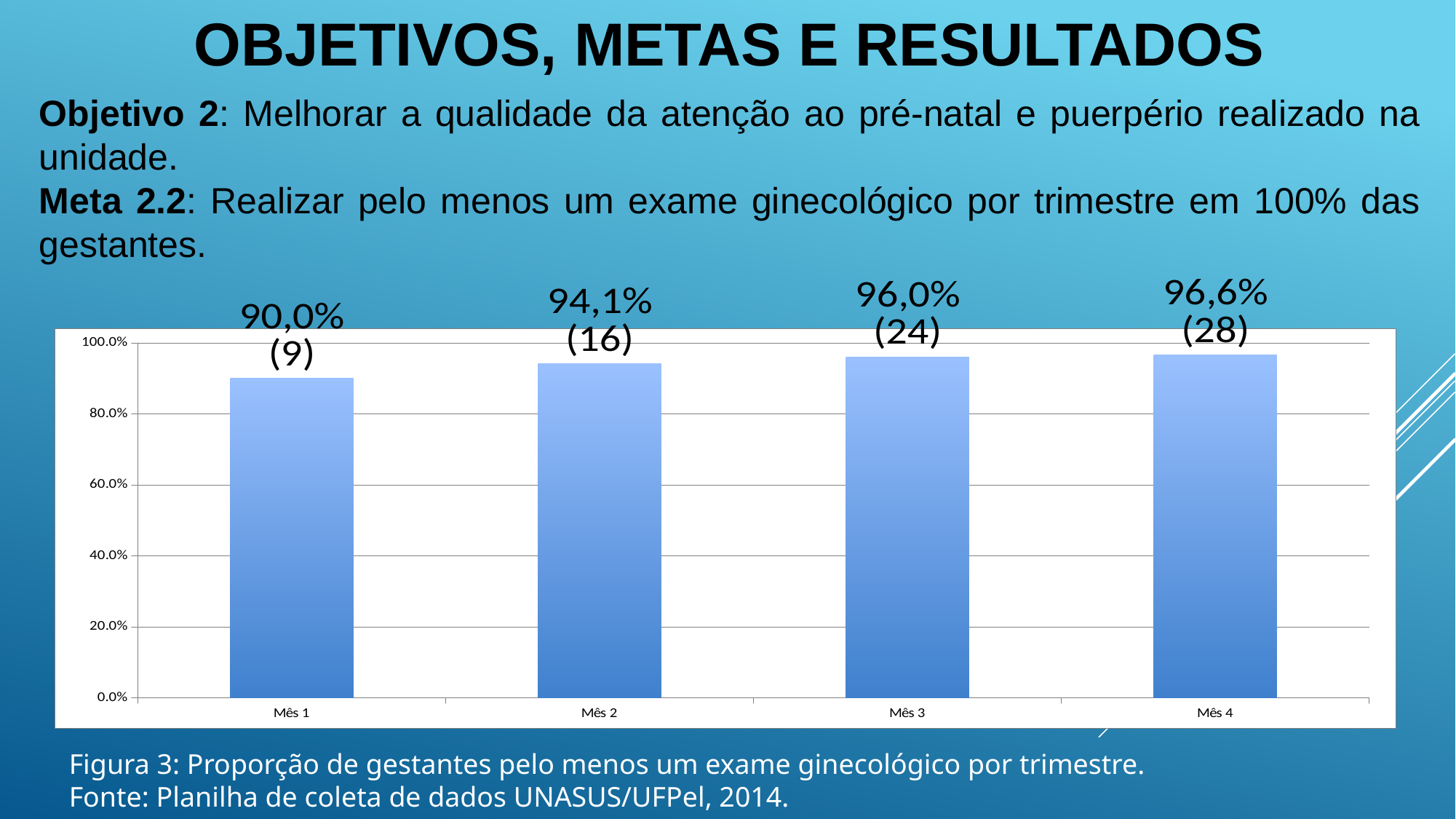
What is the percentage value shown for Mês 3? 96,0% What is the percentage value shown for Mês 1? 90,0% Which month has the lowest percentage? Mês 1 Do the values rise or fall from Mês 1 to Mês 4? Rise What is the percentage value shown for Mês 2? 94,1% What is the figure caption below the chart? Figura 3: Proporção de gestantes pelo menos um exame ginecológico por trimestre. Which month has the highest percentage? Mês 4 What kind of chart is shown on the slide? Bar chart What is the difference in percentage points between Mês 2 and Mês 1? 4,1 How many months (categories) are shown on the chart? 4 Which is larger, the value for Mês 2 or the value for Mês 1? Mês 2 What is the count shown in parentheses for Mês 4? 28